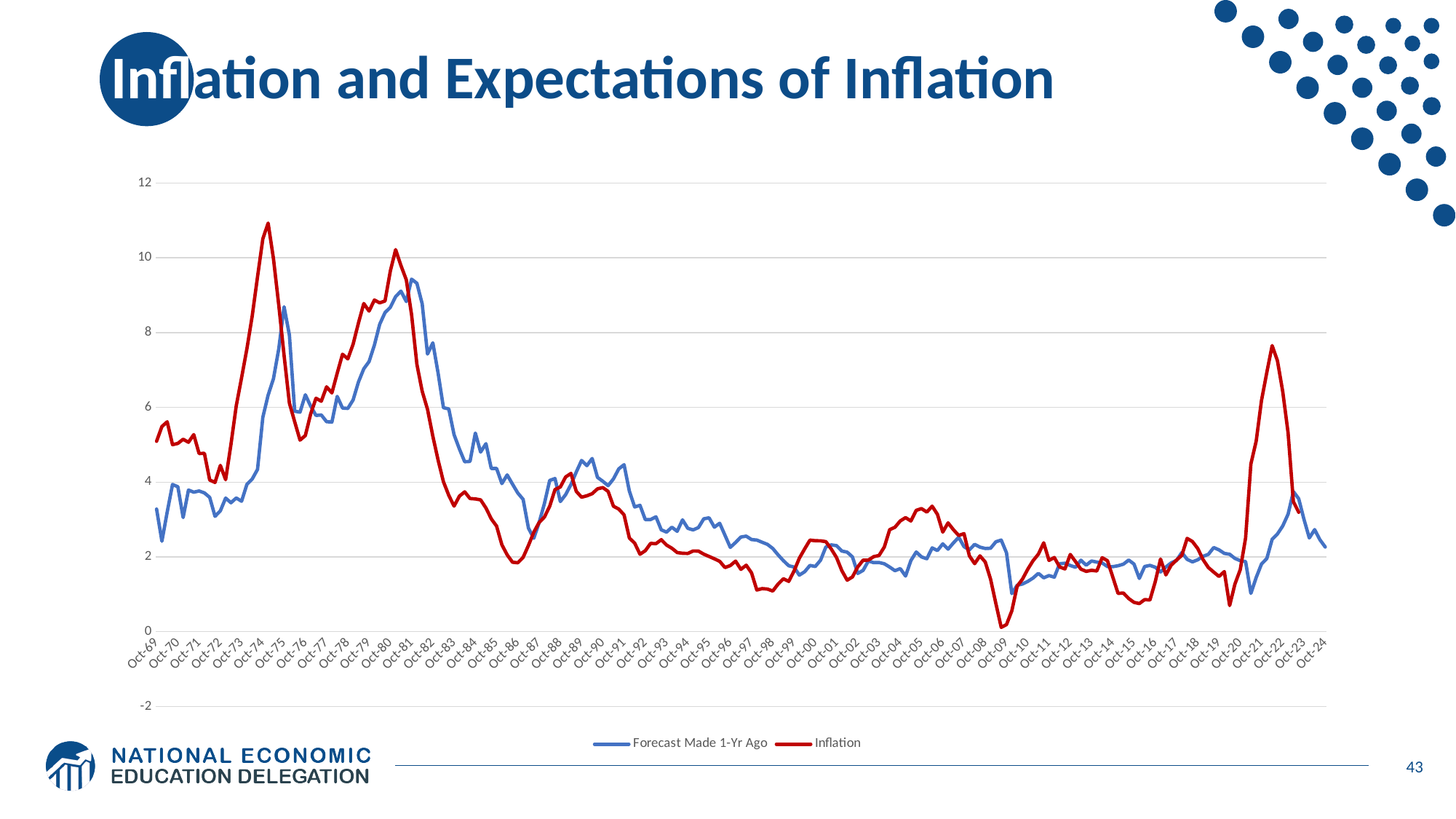
Is the peak value of the Inflation series around Oct-21 to Oct-22 greater or less than 6? greater Is the value of the Forecast Made 1-Yr Ago series around Oct-81 greater or less than 8? greater Which series reaches the higher peak around Oct-74, Forecast Made 1-Yr Ago or Inflation? Inflation How many series does the legend list? 2 What kind of chart is shown on the slide? line chart Does the Forecast Made 1-Yr Ago series rise or fall between Oct-81 and Oct-86? fall What is the title of the chart on the slide? Inflation and Expectations of Inflation Which colour is used for the Inflation series? red Is the value of the Inflation series around Oct-98 greater or less than 2? less Around Oct-09, which series has the lower value, Forecast Made 1-Yr Ago or Inflation? Inflation